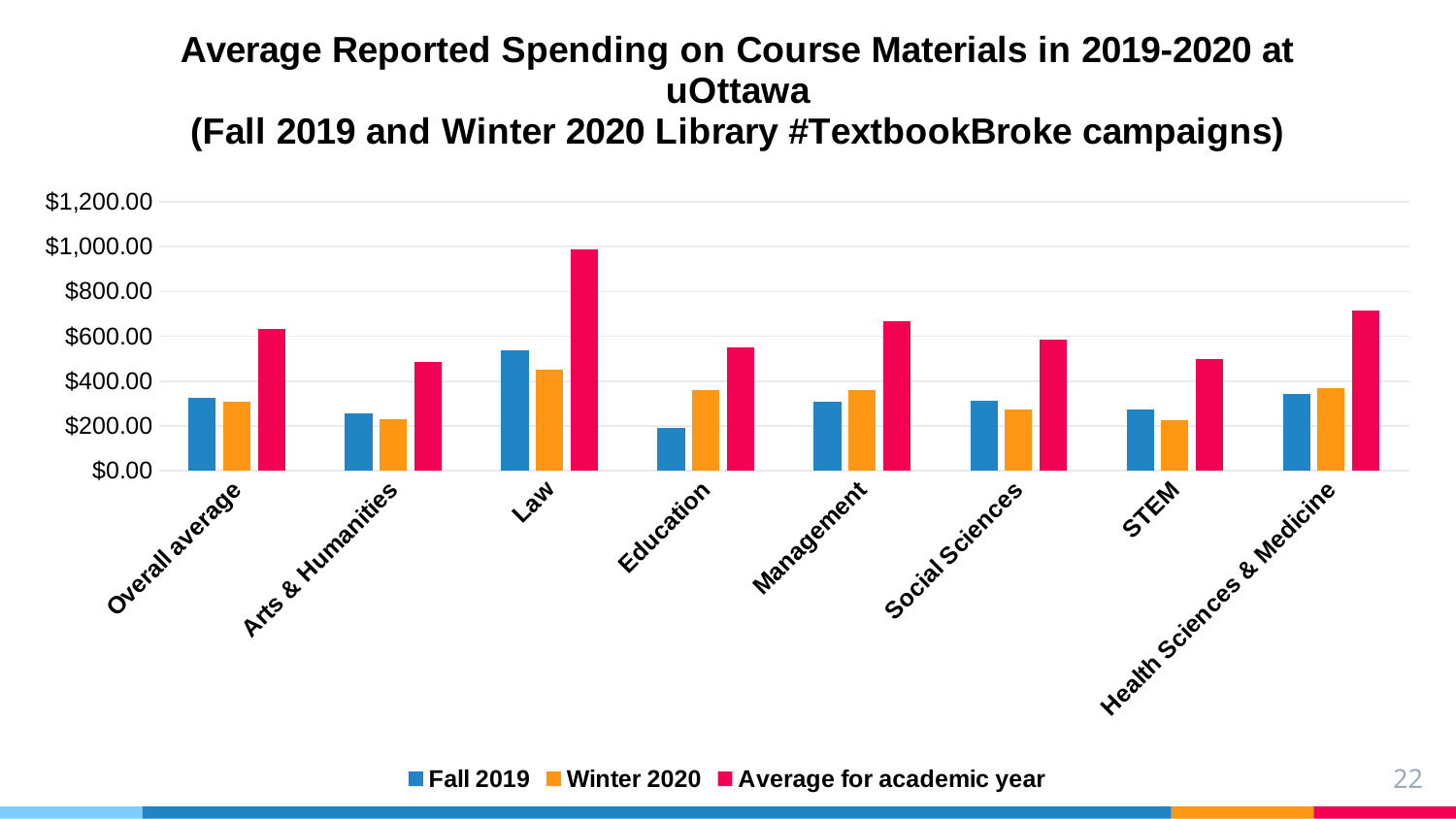
Is the Average for academic year value for Health Sciences & Medicine greater or less than $600.00? greater Which category has the highest value for the Average for academic year series? Law For Law, which is larger: the Fall 2019 value or the Winter 2020 value? Fall 2019 Which category has the highest value for the Fall 2019 series? Law Which series is shown in red in the legend? Average for academic year Is the Fall 2019 value for Education greater or less than $400.00? less How many categories are shown on the x axis? 8 What kind of chart is shown on the slide? bar chart Which category has the lowest value for the Fall 2019 series? Education How many series does the legend list? 3 For Education, which is larger: the Fall 2019 value or the Winter 2020 value? Winter 2020 Is the Average for academic year value for Law greater or less than $800.00? greater